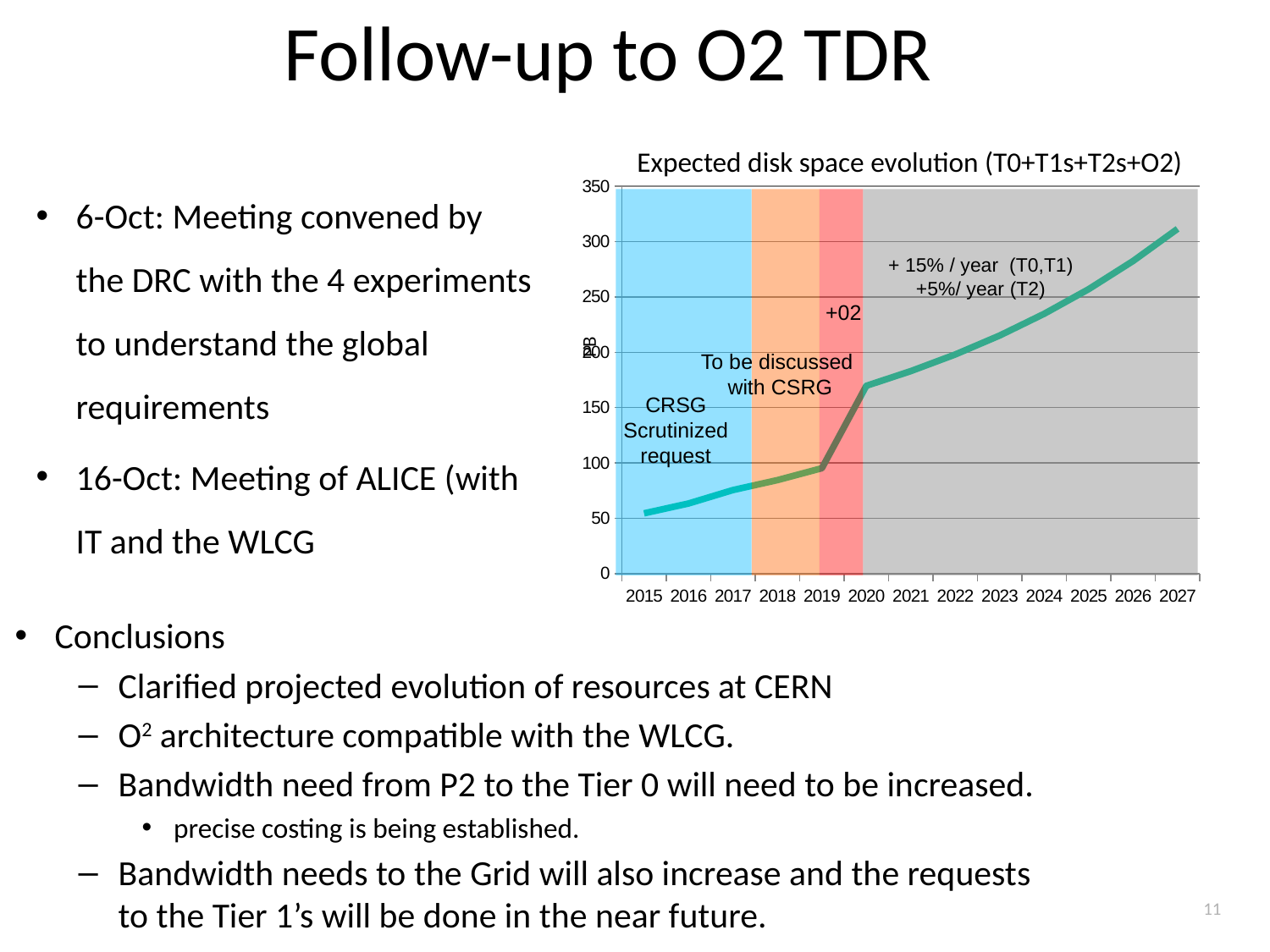
Is the value for 2026 greater or less than 250? greater Is the value for 2015 greater or less than 100? less Is the value for 2018 greater or less than 100? less How many years are shown on the x axis of the chart? 13 What is the title of the chart? Expected disk space evolution (T0+T1s+T2s+O2) What type of chart is shown on the slide? line chart Do the values rise or fall from 2015 to 2027? rise Which year has the larger value, 2019 or 2023? 2023 Which year has the highest value on the chart? 2027 Which year has the lowest value on the chart? 2015